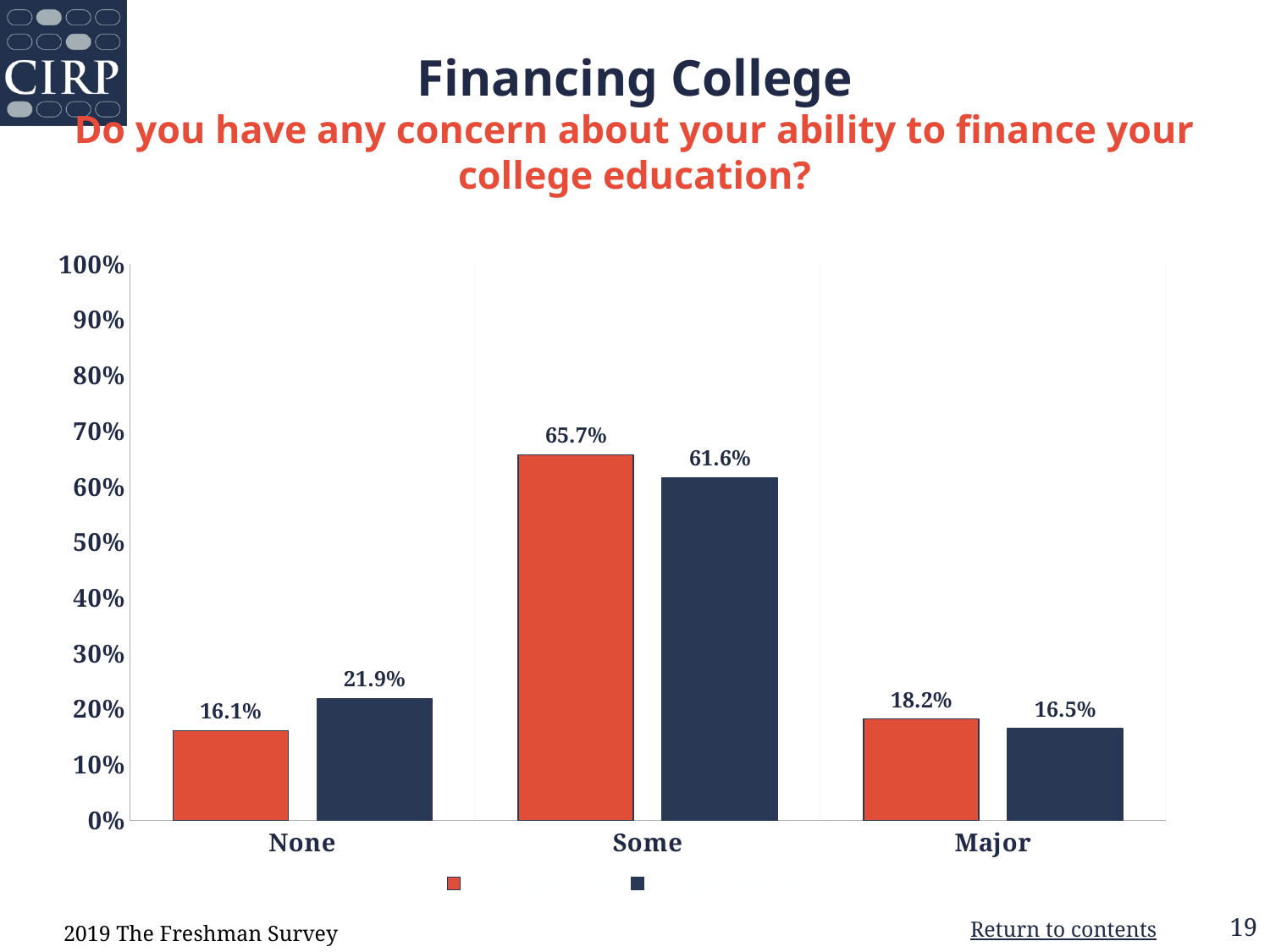
What is the value of the dark blue bar for the "Some" category? 61.6% What is the value of the orange bar for the "Major" category? 18.2% Is the value of the dark blue bar for "Major" greater or less than 20%? less How many series does the legend list? 2 What is the difference between the orange and dark blue bars for the "Some" category? 4.1% What is the value of the orange bar for the "Some" category? 65.7% For the "None" category, which bar is larger, the orange bar or the dark blue bar? the dark blue bar What is the value of the dark blue bar for the "None" category? 21.9% Which category has the lowest value for the dark blue bars? Major What kind of chart is shown on the slide? bar chart How many categories are shown on the x axis? 3 Which category has the highest value for the orange bars? Some